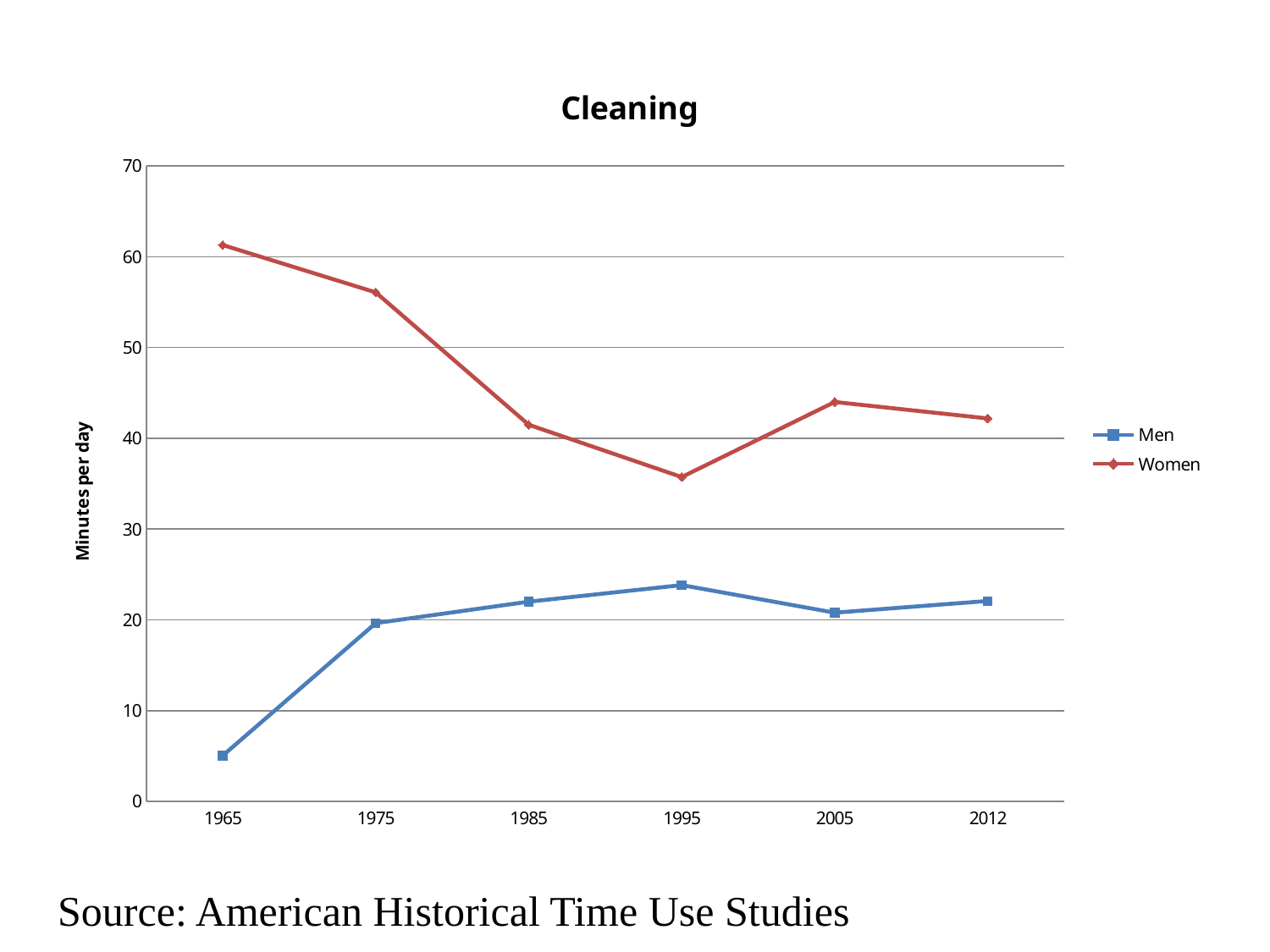
What is the label on the y axis? Minutes per day How many years are plotted along the x axis? 6 How many series does the legend list? 2 In which year is the Women series at its lowest? 1995 Is the value for Men in 1965 greater or less than 10? less In which year is the Women series at its highest? 1965 Which series has the larger value in 2012, Men or Women? Women In which year is the Men series at its lowest? 1965 Does the Women series overall rise or fall from 1965 to 2012? fall What kind of chart is shown on the slide? line chart Is the value for Women in 1965 greater or less than 50? greater Is the value for Women in 1995 greater or less than 40? less